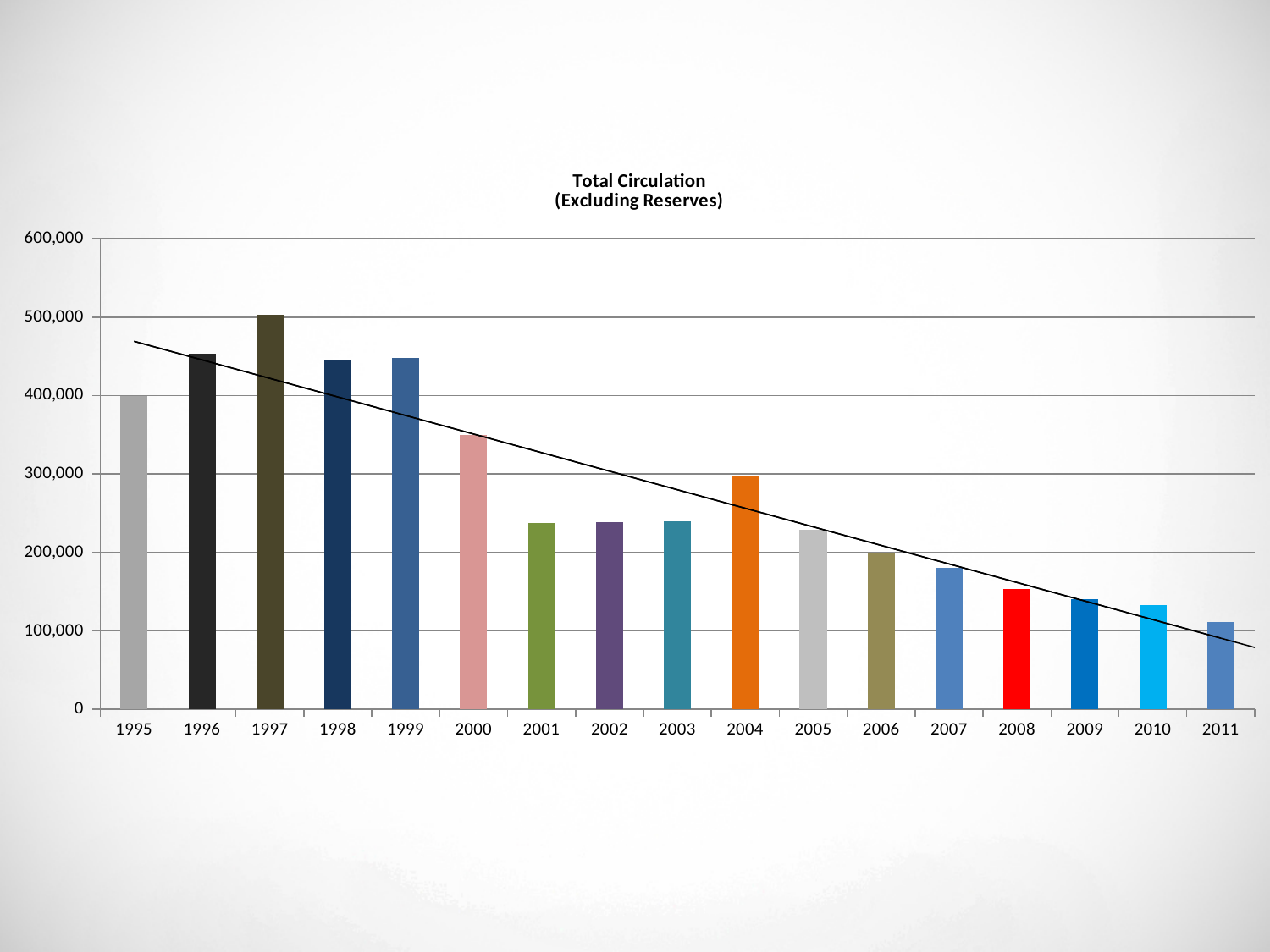
Which year has the larger value, 2000 or 2004? 2000 Is the value for 2001 greater or less than 300,000? less How many years are shown on the x axis of the chart? 17 Which year has the highest total circulation? 1997 What is the title of the chart? Total Circulation (Excluding Reserves) Which year has the larger value, 1995 or 2005? 1995 Is the value for 2000 greater or less than 300,000? greater Overall, do the values rise or fall from 1995 to 2011? Fall Which year has the lowest total circulation? 2011 Is the value for 2011 greater or less than 100,000? greater What kind of chart is shown on the slide? Bar chart